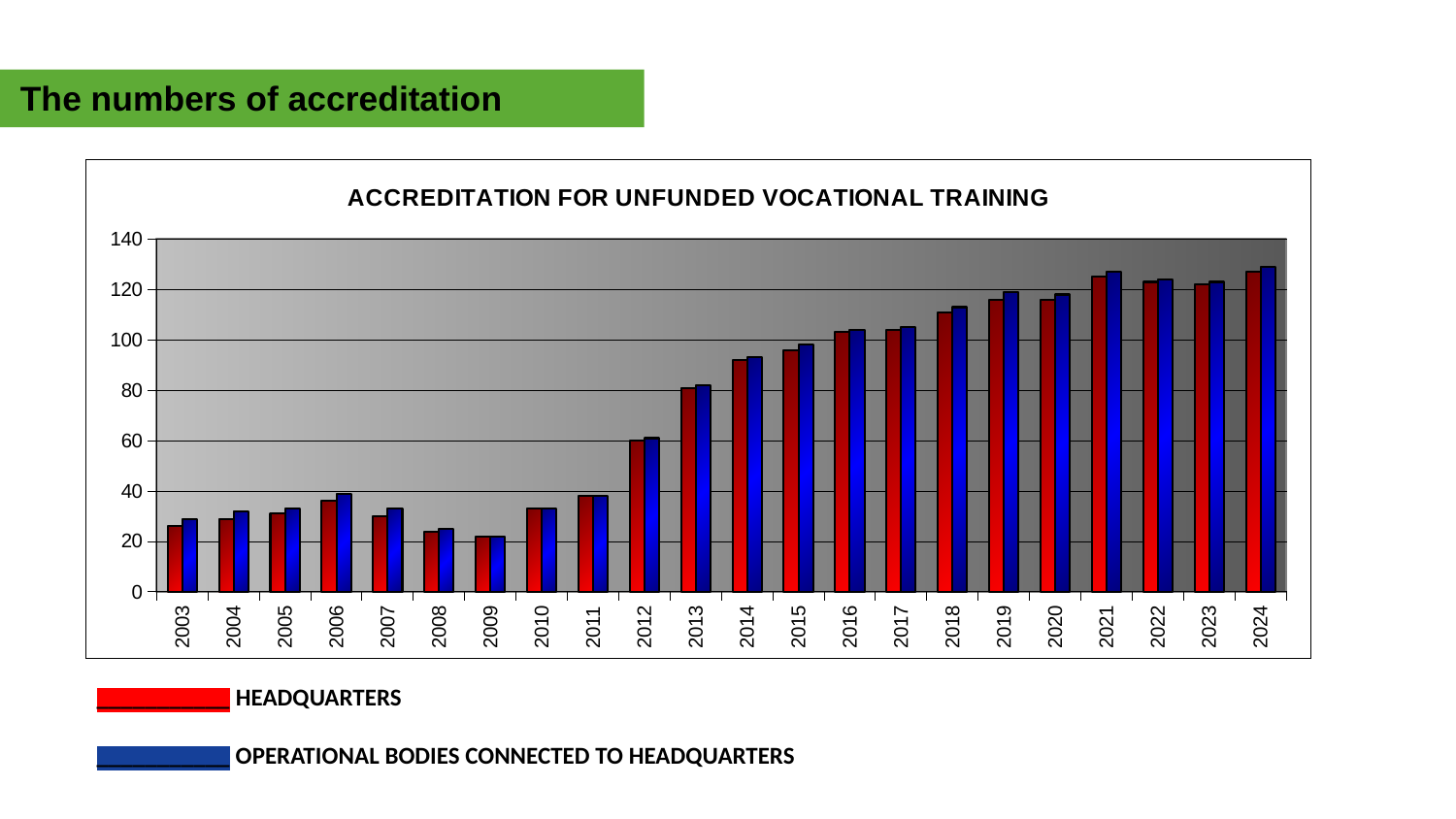
Is the OPERATIONAL BODIES CONNECTED TO HEADQUARTERS value for 2021 greater or less than 120? greater Is the HEADQUARTERS value for 2003 greater or less than 40? less What kind of chart is shown on the slide? bar chart Which series is shown in red? HEADQUARTERS How many years are shown on the x axis of the chart? 22 How many series does the legend list? 2 Is the HEADQUARTERS value for 2018 greater or less than 100? greater Which year has the larger HEADQUARTERS value, 2003 or 2012? 2012 Do the values generally rise or fall from 2003 to 2024? rise What is the title of the chart? ACCREDITATION FOR UNFUNDED VOCATIONAL TRAINING